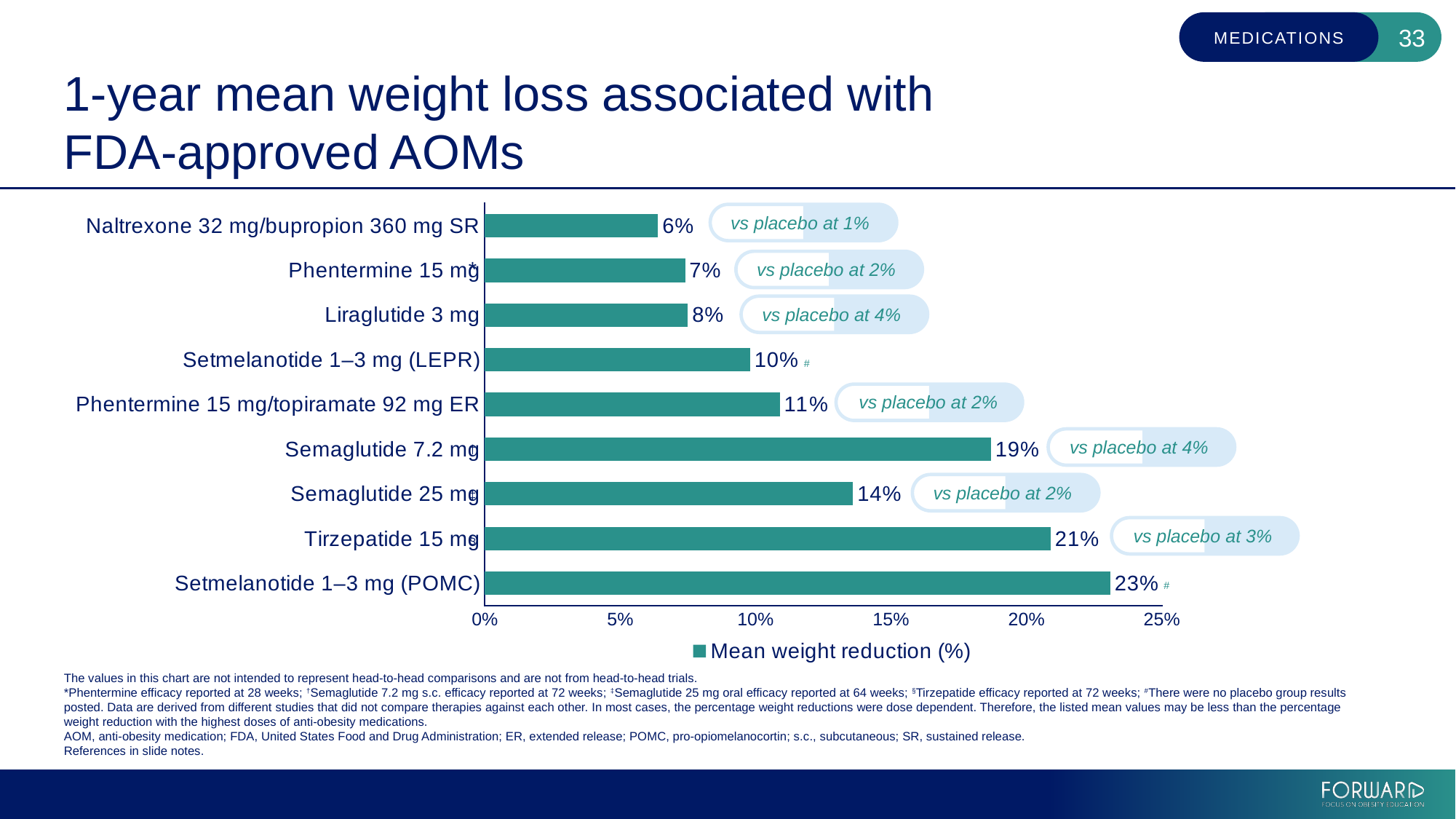
Is the value for Setmelanotide 1–3 mg (POMC) greater or less than 20%? greater Which medication has the highest mean weight reduction? Setmelanotide 1–3 mg (POMC) What kind of chart is shown on the slide? Bar chart How many series does the legend list? 1 Which has a larger mean weight reduction, Tirzepatide 15 mg or Semaglutide 7.2 mg? Tirzepatide 15 mg What is the mean weight reduction for Tirzepatide 15 mg? 21% What is the mean weight reduction for Phentermine 15 mg/topiramate 92 mg ER? 11% What is the legend entry for the plotted series? Mean weight reduction (%) Which medication has the lowest mean weight reduction? Naltrexone 32 mg/bupropion 360 mg SR How many medications are shown in the chart? 9 What is the mean weight reduction for Liraglutide 3 mg? 8% What is the difference in mean weight reduction between Semaglutide 7.2 mg and Semaglutide 25 mg? 5%